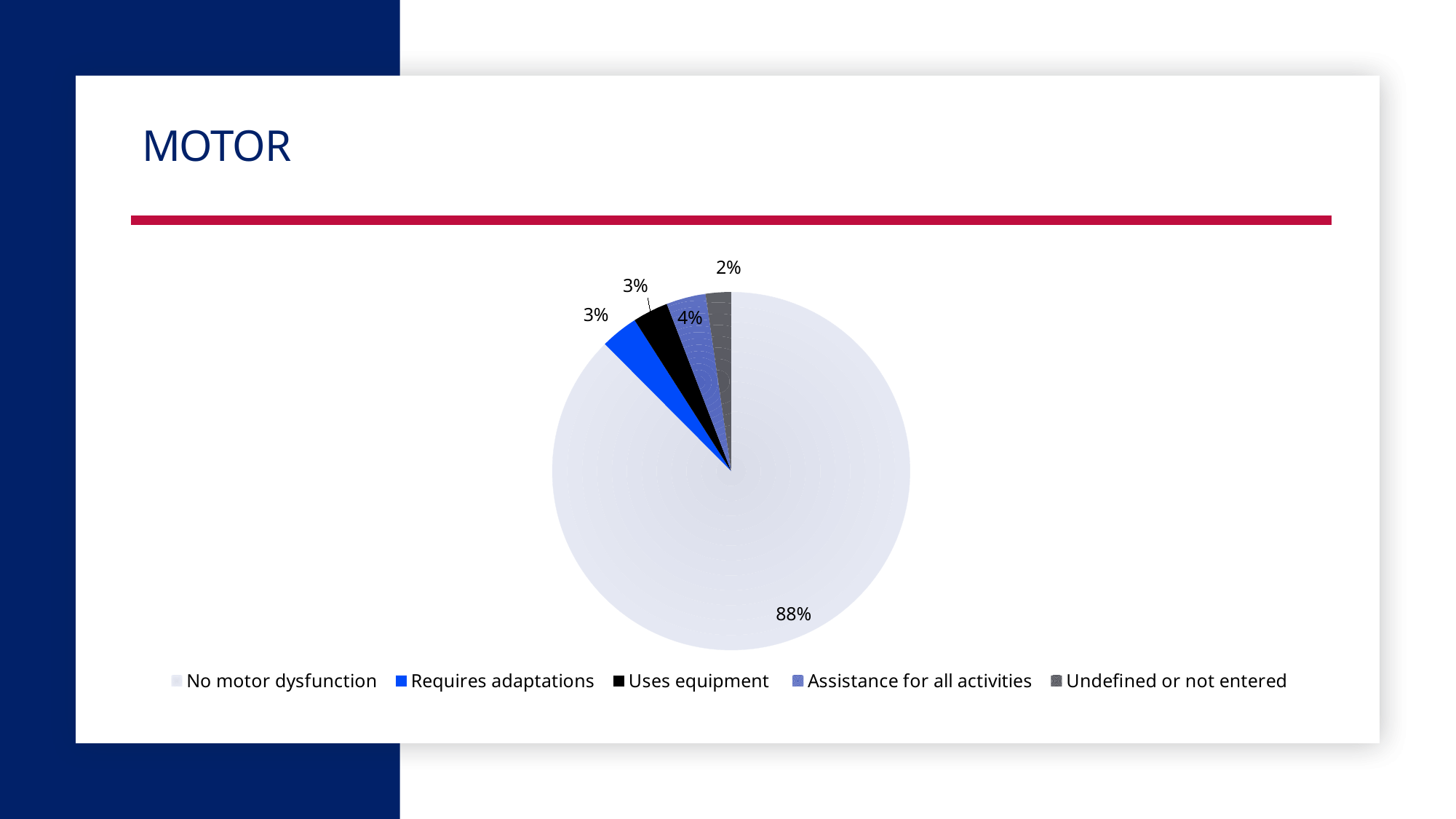
What kind of chart is shown on the slide? Pie chart Which category has the largest share of the pie? No motor dysfunction What percentage of the pie is 'Uses equipment'? 3% What percentage of the pie is 'Undefined or not entered'? 2% What percentage of the pie is 'No motor dysfunction'? 88% Which is larger: the share for 'Assistance for all activities' or the share for 'Undefined or not entered'? Assistance for all activities What percentage of the pie is 'Assistance for all activities'? 4% How many categories does the pie chart show? 5 What is the difference in percentage points between 'No motor dysfunction' and 'Assistance for all activities'? 84 What is the title of the slide containing the chart? MOTOR Which category has the smallest share of the pie? Undefined or not entered What percentage of the pie is 'Requires adaptations'? 3%